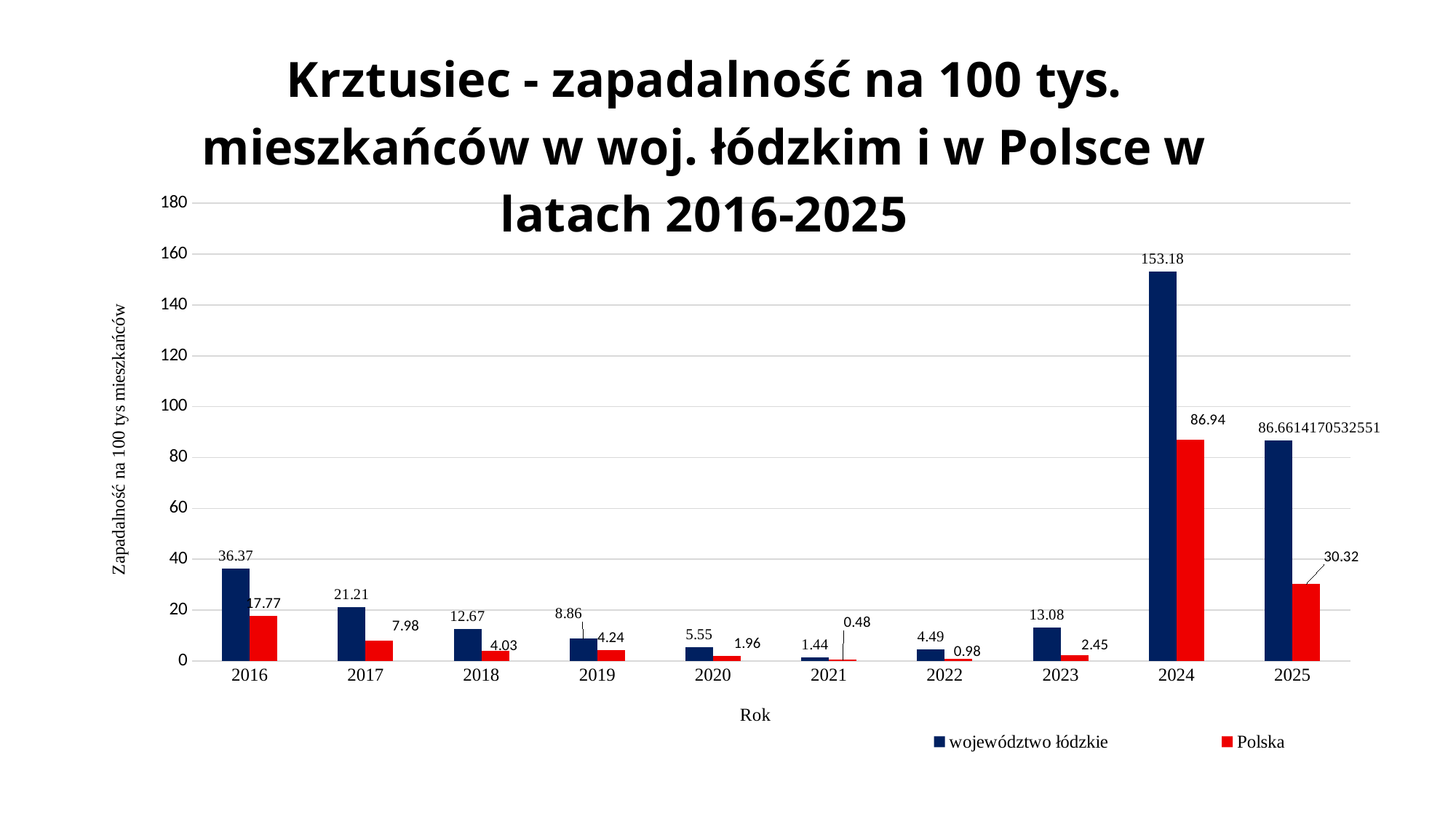
What is the value for województwo łódzkie in 2024? 153.18 What is the value for Polska in 2017? 7.98 Which is larger in 2016, województwo łódzkie or Polska? województwo łódzkie Is the value for województwo łódzkie in 2025 greater or less than 80? greater Which year has the highest value for województwo łódzkie? 2024 What kind of chart is shown? bar chart What is the difference between województwo łódzkie and Polska in 2024? 66.24 Which year has the lowest value for Polska? 2021 How many series does the legend list? 2 What is the label of the y axis? Zapadalność na 100 tys mieszkańców What is the value for Polska in 2025? 30.32 How many years are shown on the x axis? 10